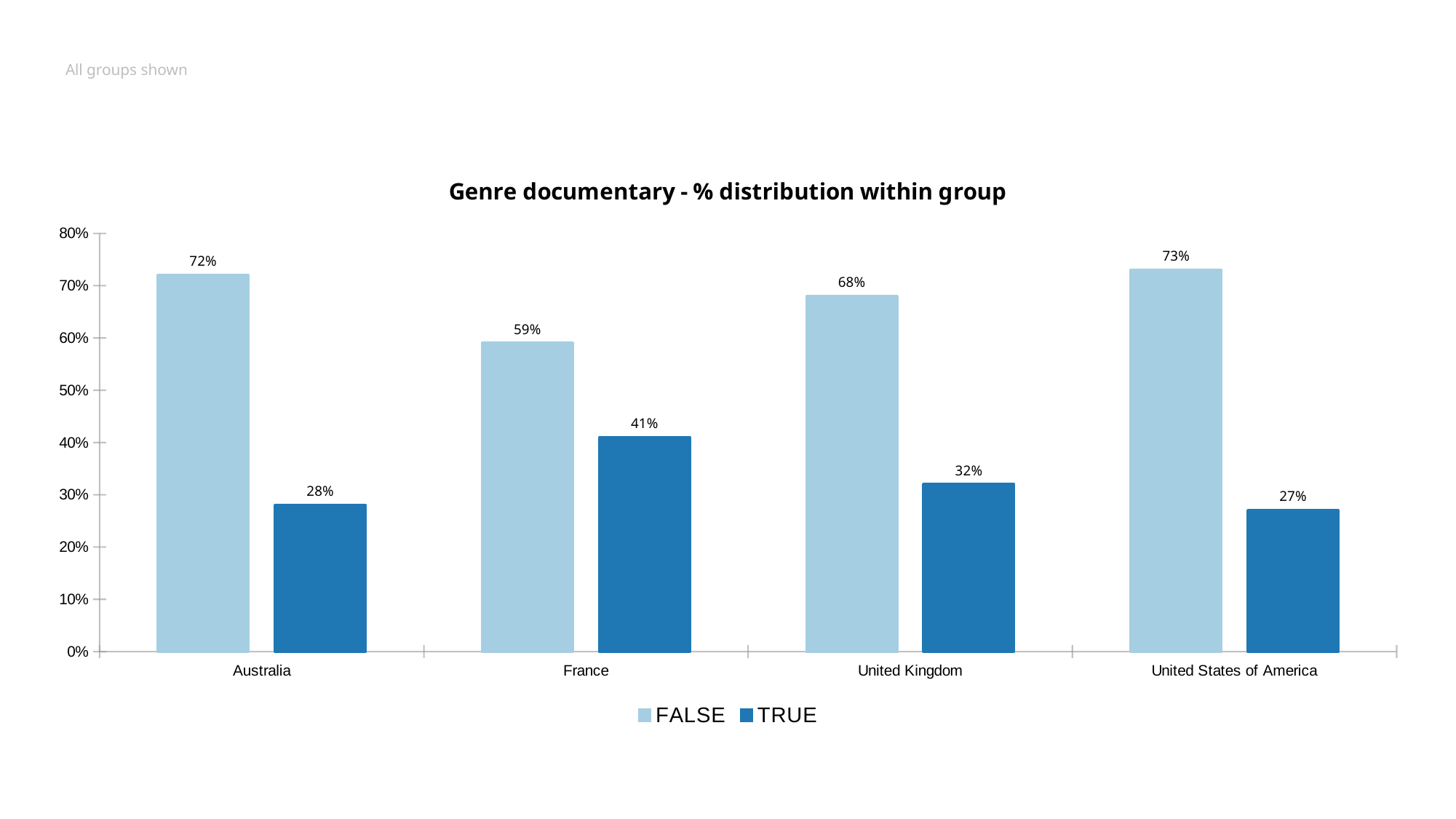
What is the FALSE value for United Kingdom? 68% What is the TRUE value for United States of America? 27% Which country has the highest TRUE value? France Which is larger: the TRUE value for United Kingdom or the TRUE value for Australia? United Kingdom Is the FALSE value for France greater or less than 60%? less What is the difference between the FALSE and TRUE values for Australia? 44% What kind of chart is shown? bar chart What is the TRUE value for France? 41% Which country has the lowest FALSE value? France What is the title of the chart? Genre documentary - % distribution within group How many series does the legend list? 2 How many countries are shown on the x axis? 4